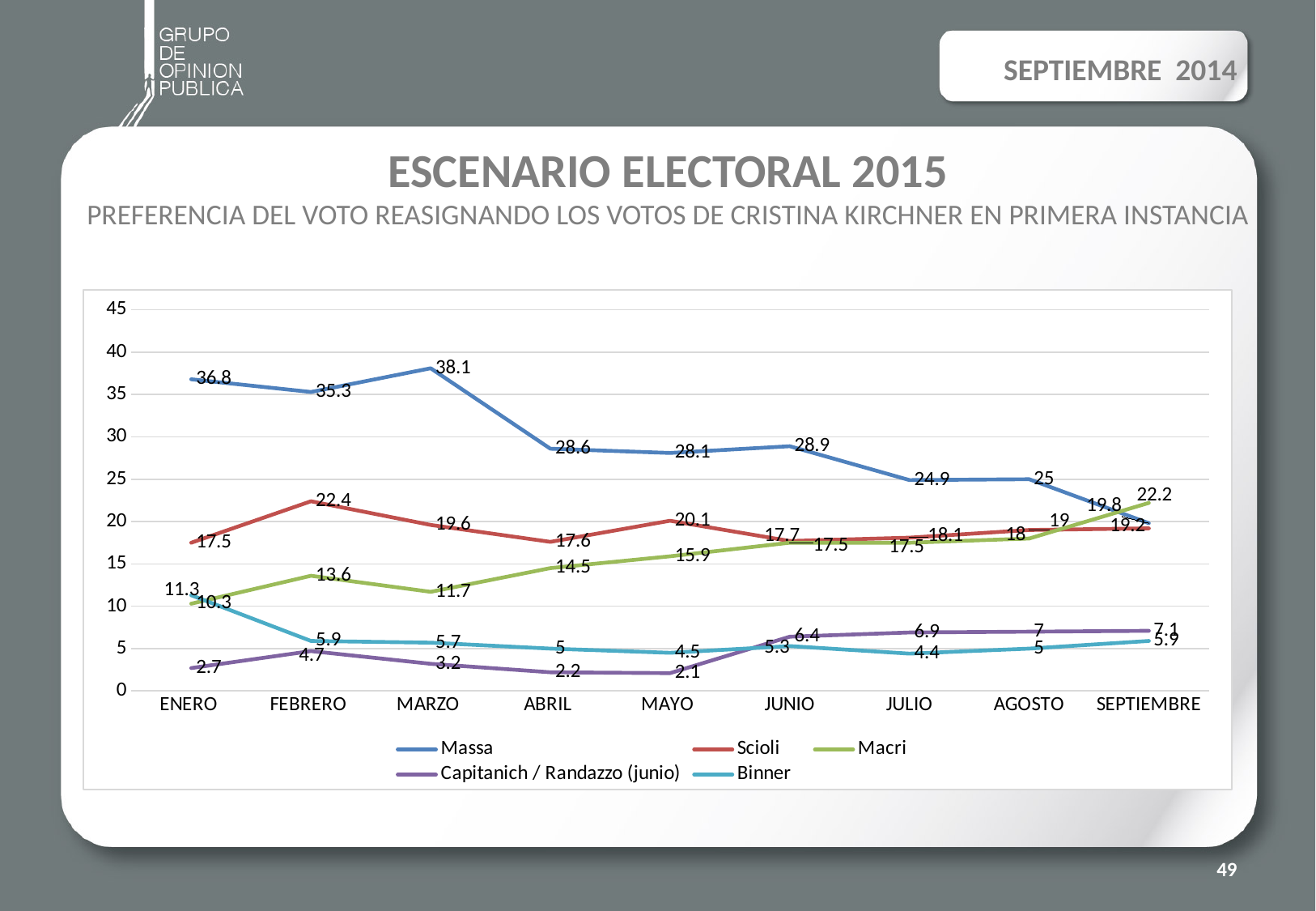
What kind of chart is shown on the slide? Line chart In which month does Capitanich / Randazzo (junio) have its lowest value? MAYO What is the value for Macri in SEPTIEMBRE? 22.2 What is the difference between Massa's value in ENERO and in SEPTIEMBRE? 17 What is the value for Scioli in FEBRERO? 22.4 In which month does Massa reach its highest value? MARZO How many series does the legend list? 5 Does the Massa line generally rise or fall from ENERO to SEPTIEMBRE? Fall What is the value for Massa in MARZO? 38.1 How many months are shown on the x axis? 9 In FEBRERO, which is larger: Scioli or Macri? Scioli What is the value for Binner in ENERO? 11.3